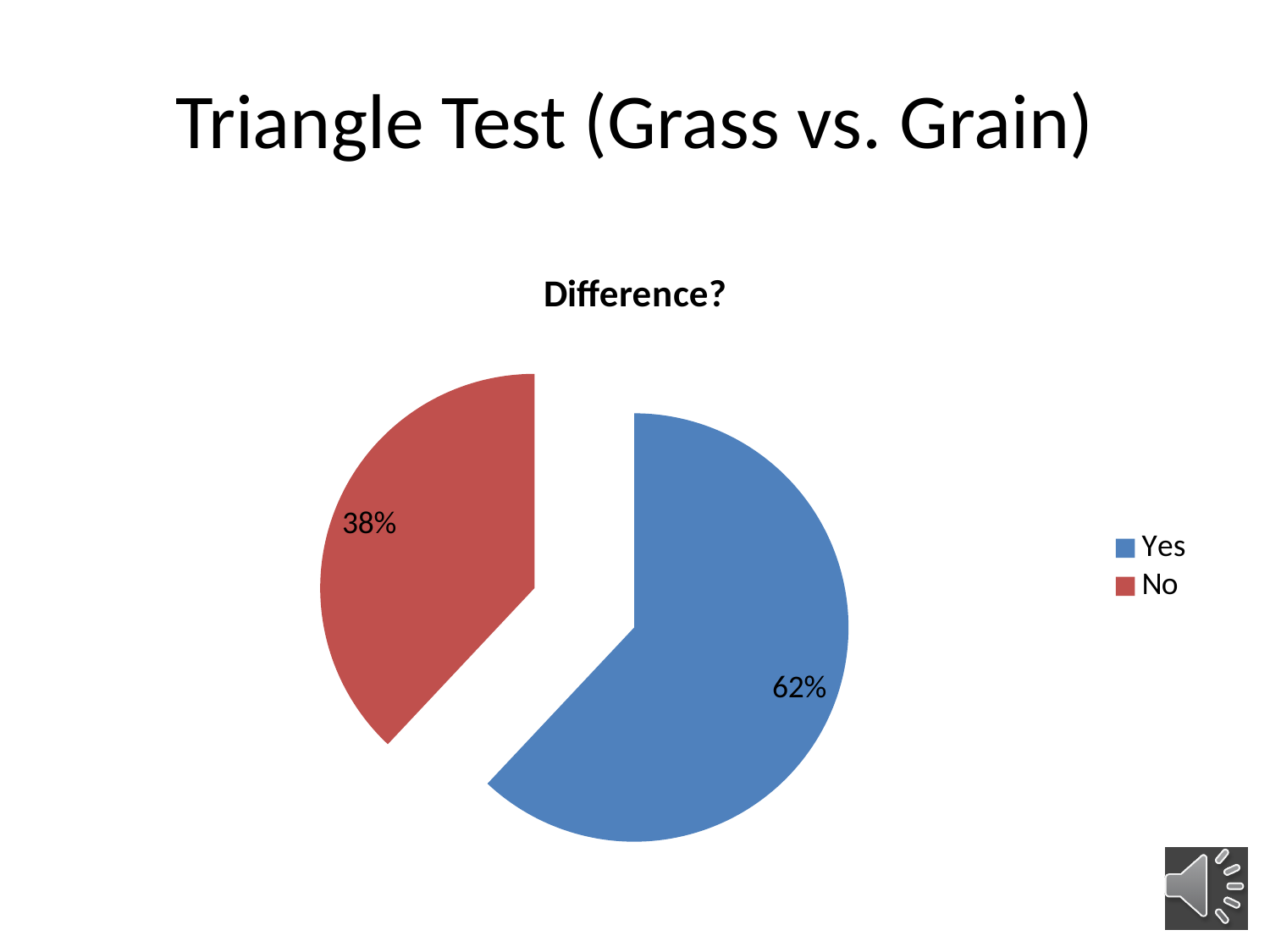
What colour is the "No" slice? red What is the difference in percentage points between the "Yes" and "No" slices? 24 Which is larger, the "Yes" slice or the "No" slice? Yes What type of chart is shown on the slide? pie chart What share of the pie does the "Yes" slice represent? 62% What is the title of the chart? Difference? What percentage of the pie is the "Yes" slice? 62% How many entries does the legend list? 2 Which slice is the largest in the pie chart? Yes What percentage of the pie is the "No" slice? 38% Which slice is the smallest in the pie chart? No How many slices does the pie chart have? 2